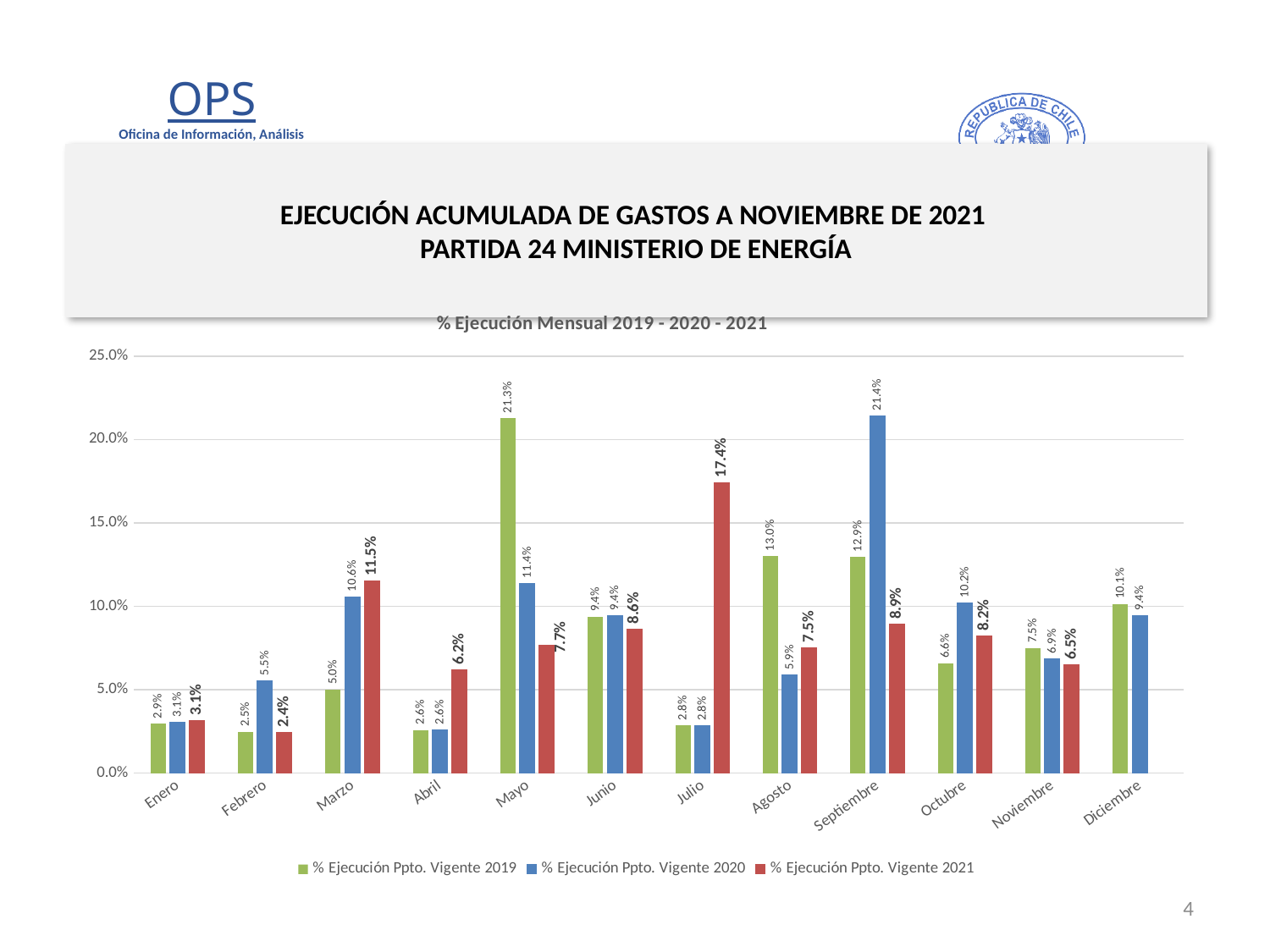
Which series is shown in red? % Ejecución Ppto. Vigente 2021 What is the title of the chart? % Ejecución Mensual 2019 - 2020 - 2021 What kind of chart is shown on the slide? Bar chart How many series does the legend list? 3 What is the difference between the 2020 and 2019 values in Marzo? 5.6% What is the value for % Ejecución Ppto. Vigente 2021 in Julio? 17.4% Which is larger in Agosto: the 2019 value or the 2020 value? 2019 value In which month is the % Ejecución Ppto. Vigente 2021 series highest? Julio What is the value for % Ejecución Ppto. Vigente 2019 in Mayo? 21.3% In which month is the % Ejecución Ppto. Vigente 2021 series lowest? Febrero What is the value for % Ejecución Ppto. Vigente 2020 in Septiembre? 21.4% How many months are shown on the x axis? 12